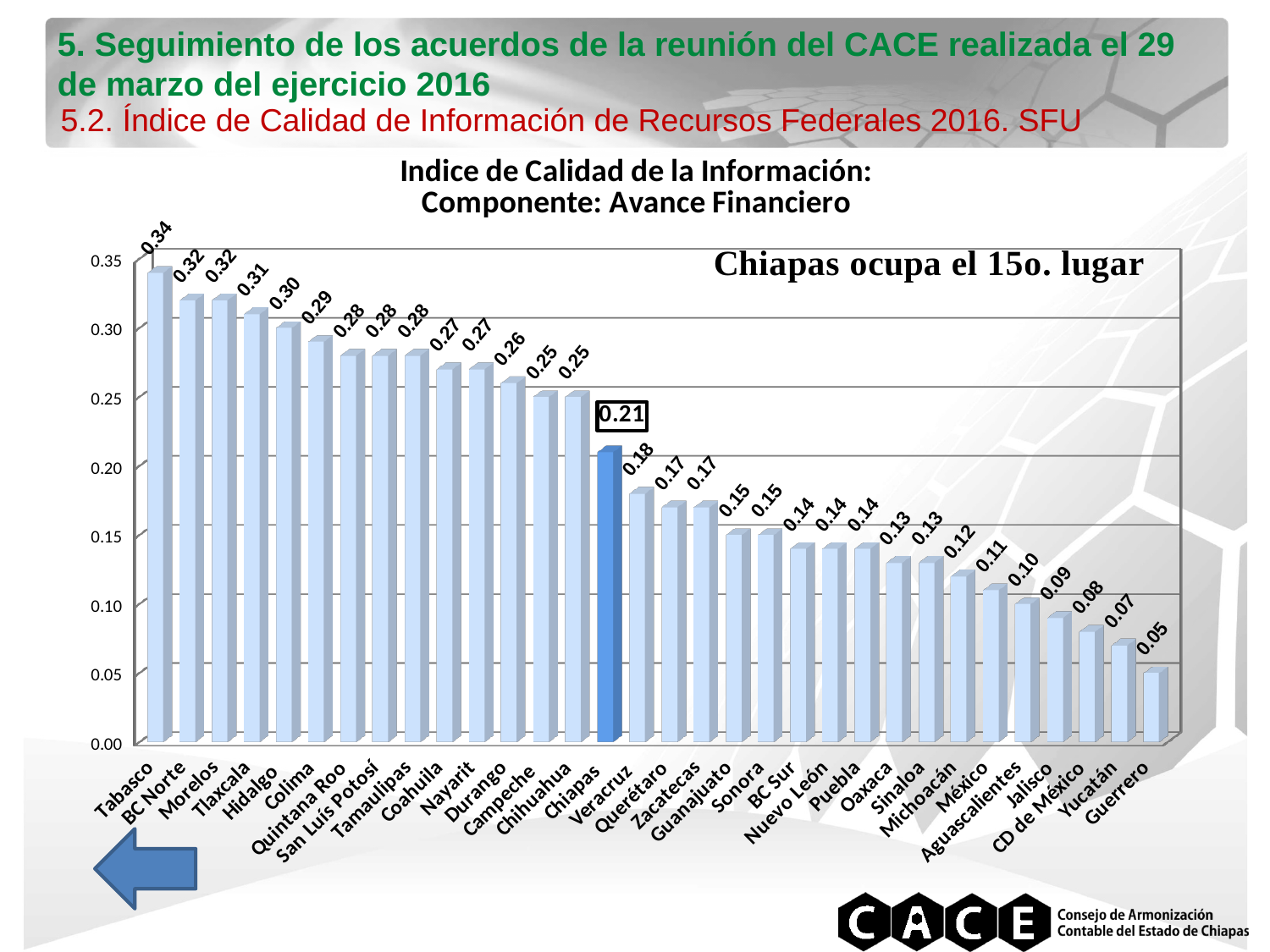
What is the value for Guerrero? 0.05 Which state has the lowest value? Guerrero According to the text on the chart, what place does Chiapas occupy? 15o. lugar What kind of chart is shown on the slide? Bar chart Which state has the highest value? Tabasco What is the value for Chiapas? 0.21 What is the difference between the values for Tabasco and Chiapas? 0.13 What is the value for Michoacán? 0.12 Do the values rise or fall from left to right along the x axis? Fall How many states are shown in the chart? 32 Which has a larger value, Hidalgo or Colima? Hidalgo What is the value for Tabasco? 0.34